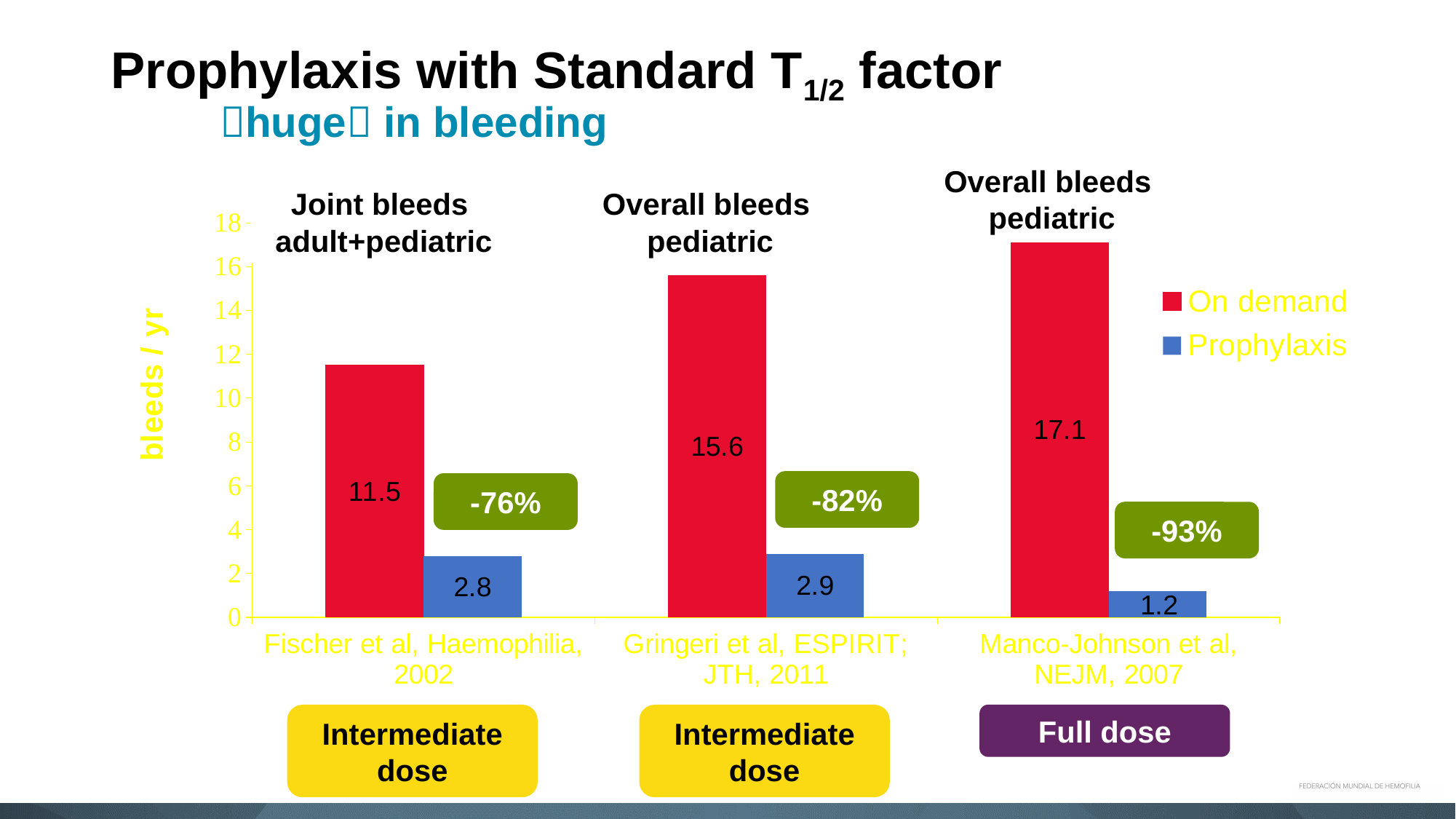
How many studies (categories) are shown on the x axis? 3 What is the Prophylaxis value for Gringeri et al, ESPIRIT; JTH, 2011? 2.9 Which study has the lowest Prophylaxis value? Manco-Johnson et al, NEJM, 2007 Which study has the highest On demand value? Manco-Johnson et al, NEJM, 2007 What is the difference between the On demand and Prophylaxis values for Fischer et al, Haemophilia, 2002? 8.7 How many series does the legend list? 2 Which is larger for Gringeri et al, ESPIRIT; JTH, 2011: the On demand value or the Prophylaxis value? On demand What is the On demand value for Fischer et al, Haemophilia, 2002? 11.5 What is the label of the y axis? bleeds / yr What is the On demand value for Manco-Johnson et al, NEJM, 2007? 17.1 What is the Prophylaxis value for Manco-Johnson et al, NEJM, 2007? 1.2 What kind of chart is shown on the slide? Bar chart